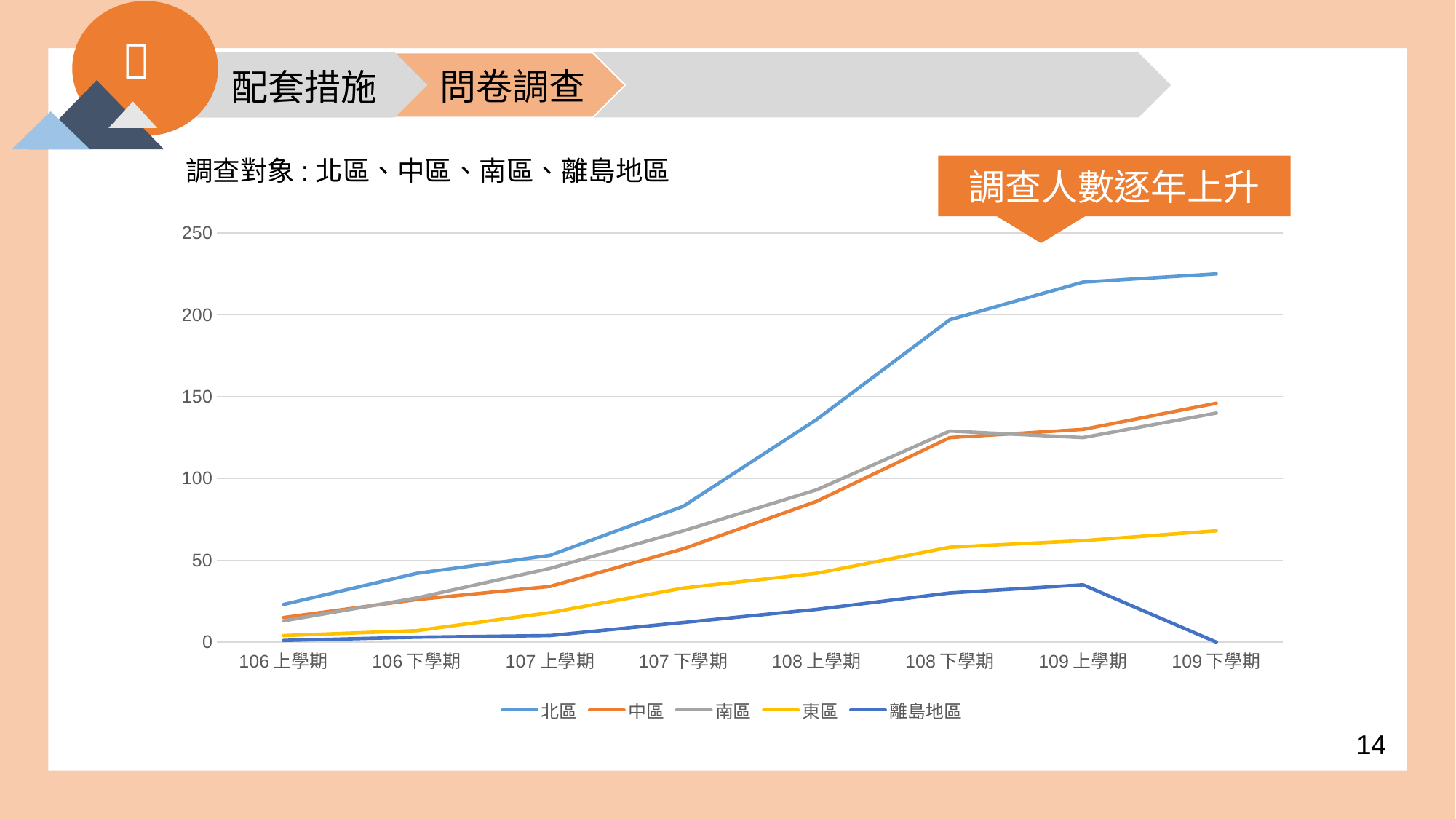
Which series has the highest value at 109 下學期? 北區 Is the value for 東區 at 109 下學期 greater or less than 100? less At 108 下學期, which is larger: 北區 or 東區? 北區 Is the value for 中區 at 108 上學期 greater or less than 100? less Does the 離島地區 line rise or fall from 109 上學期 to 109 下學期? falls Does the 北區 line rise or fall from 106 上學期 to 109 下學期? rises What kind of chart is shown on the slide? line chart How many series does the legend list? 5 Is the value for 北區 at 109 下學期 greater or less than 200? greater How many semesters (x-axis categories) are plotted on the chart? 8 Which series has the lowest value at 109 下學期? 離島地區